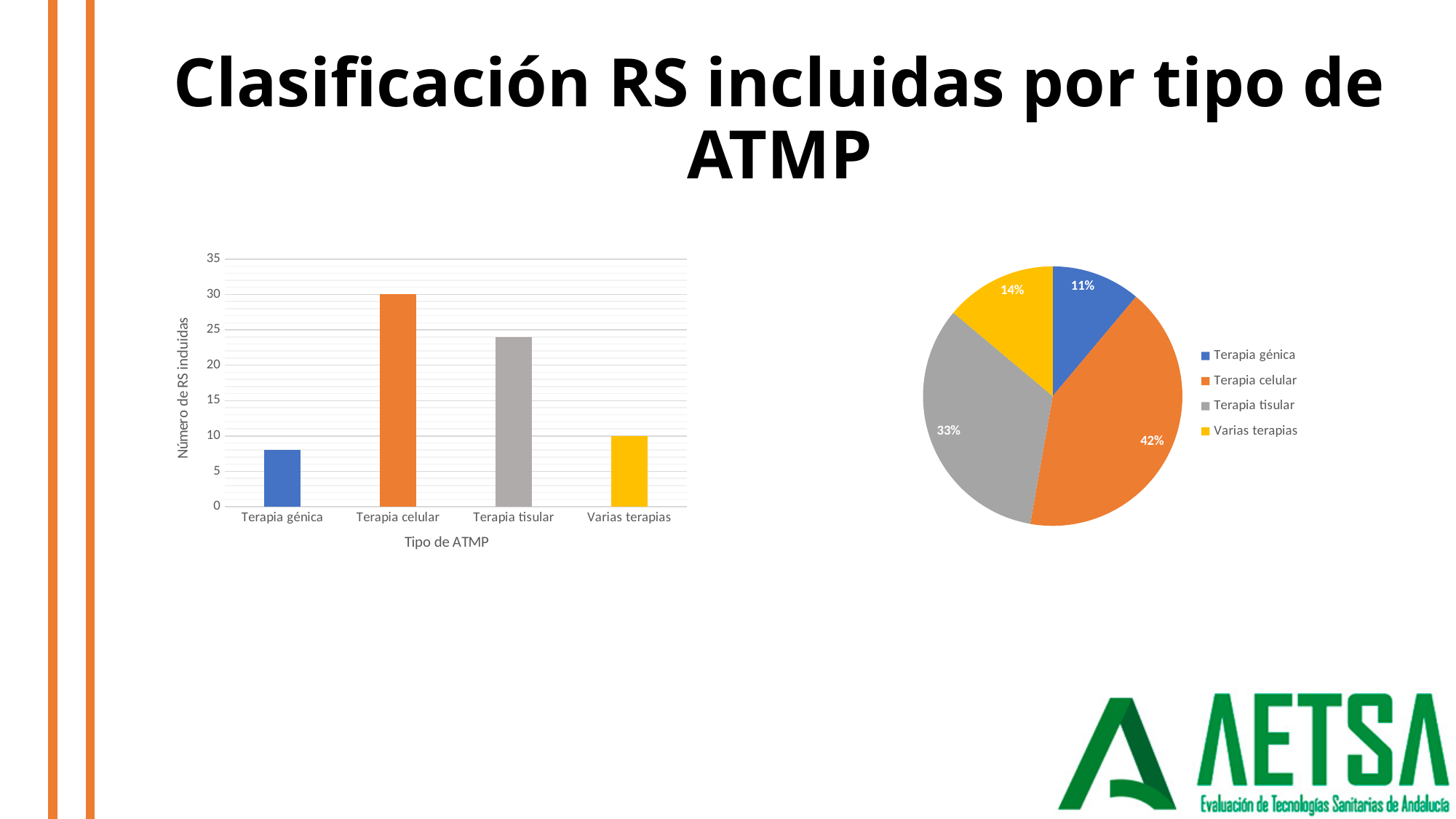
In the bar chart on the left, which category has the lowest number of RS incluidas? Terapia génica In the pie chart on the right, how many entries does the legend list? 4 In the bar chart on the left, which is larger: Terapia tisular or Varias terapias? Terapia tisular In the bar chart on the left, what is the value for Terapia celular? 30 In the bar chart on the left, what is the value for Varias terapias? 10 What kind of chart is the chart on the right of the slide? pie chart In the bar chart on the left, which category has the highest number of RS incluidas? Terapia celular What kind of chart is the chart on the left of the slide? bar chart In the pie chart on the right, what share does Terapia celular have? 42% In the bar chart on the left, how many categories are shown on the x axis? 4 In the bar chart on the left, is the value for Terapia tisular greater or less than 20? greater In the bar chart on the left, is the value for Terapia génica greater or less than 10? less